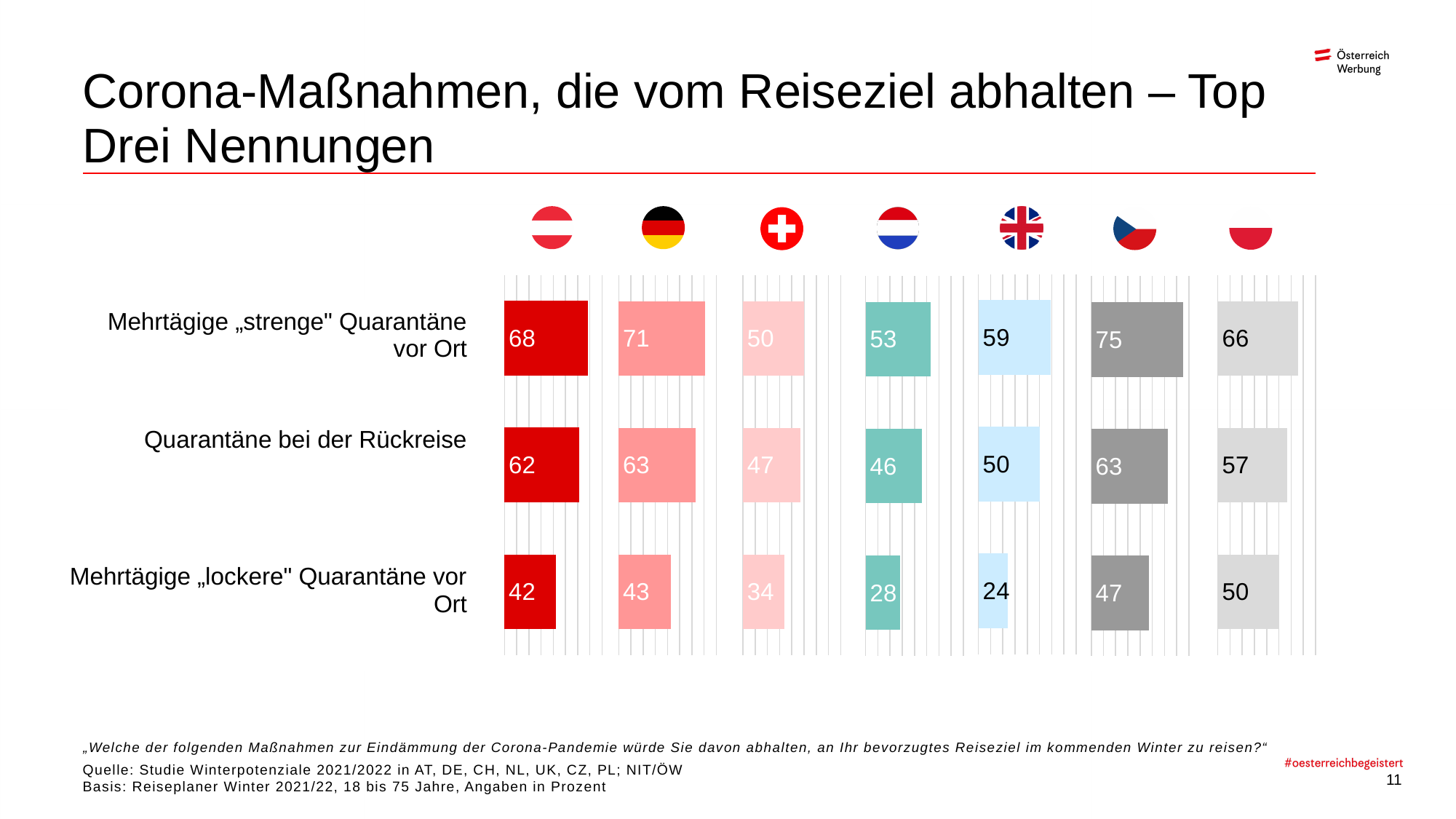
How many countries (flag columns) are shown in the chart? 7 Which is larger for "Quarantäne bei der Rückreise": the value for Poland or the value for the Netherlands? Poland (57) Which country has the lowest value for "Mehrtägige „lockere" Quarantäne vor Ort"? United Kingdom (24) What is the difference between the Czech Republic and Austria for "Mehrtägige „lockere" Quarantäne vor Ort"? 5 What is the value for the Netherlands for "Mehrtägige „lockere" Quarantäne vor Ort"? 28 Which country has the lowest value for "Quarantäne bei der Rückreise"? Netherlands (46) What is the value for the United Kingdom for "Quarantäne bei der Rückreise"? 50 How many measures (row categories) are shown in the chart? 3 What kind of chart is shown on the slide? Bar chart What is the difference between Germany and Switzerland for "Mehrtägige „strenge" Quarantäne vor Ort"? 21 What is the value for Austria (first flag column) for "Mehrtägige „strenge" Quarantäne vor Ort"? 68 Which country has the highest value for "Mehrtägige „strenge" Quarantäne vor Ort"? Czech Republic (75)